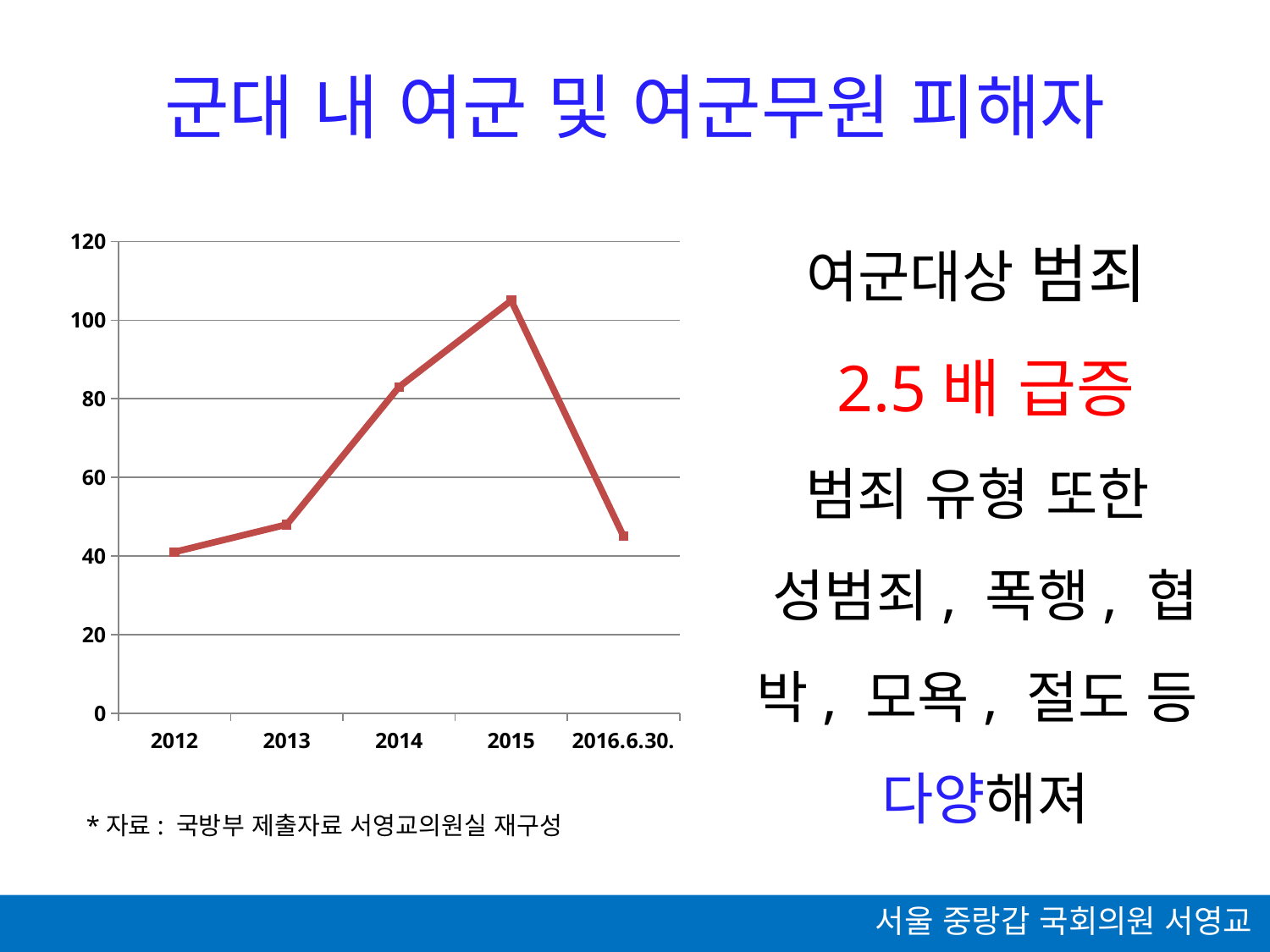
Is the value for 2013 greater or less than 60? less Is the value for 2016.6.30. greater or less than 60? less Do the values rise or fall from 2012 to 2015? rise What is the label of the last category on the x axis? 2016.6.30. Is the value for 2015 greater or less than 100? greater Which year has the highest value on the line chart? 2015 How many data points are plotted on the line chart? 5 What kind of chart is shown on the slide? line chart Which is larger, the value for 2015 or the value for 2016.6.30.? 2015 Which is larger, the value for 2014 or the value for 2013? 2014